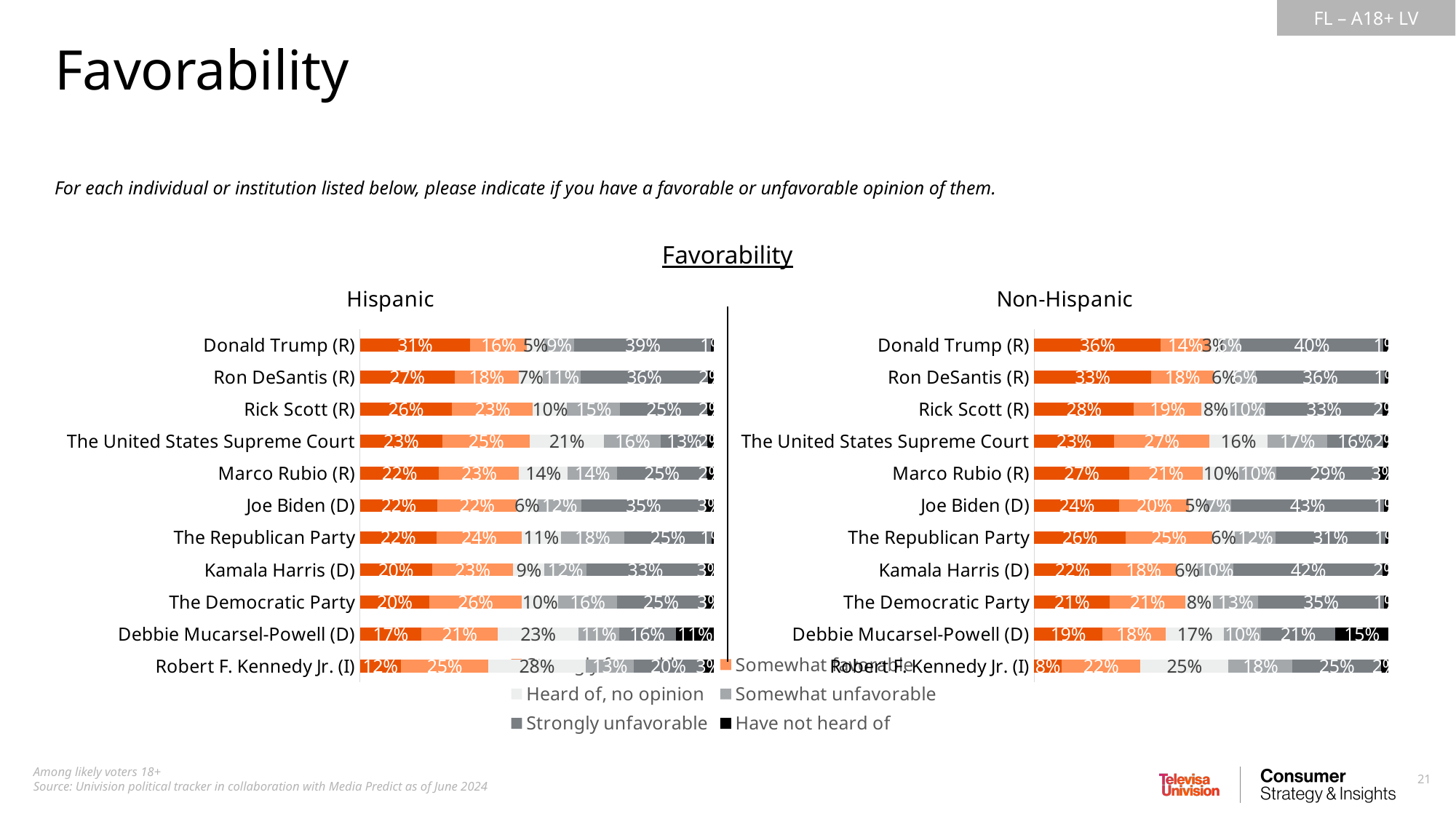
What is the difference between the first dark orange segment for Donald Trump (R) in the Non-Hispanic chart (36%) and in the Hispanic chart (31%)? 5 percentage points What type of chart is used to show the Non-Hispanic favorability data? Stacked bar chart In the Non-Hispanic chart, what is the 'Strongly unfavorable' value for Kamala Harris (D)? 42% In the Hispanic chart, what is the 'Heard of, no opinion' value for Robert F. Kennedy Jr. (I)? 28% In the Hispanic chart, what is the value of the dark gray 'Strongly unfavorable' segment for Joe Biden (D)? 35% In the Non-Hispanic chart, which individual or institution has the highest 'Strongly unfavorable' value? Joe Biden (D) In the Hispanic chart, which has the larger first dark orange segment: Rick Scott (R) or Marco Rubio (R)? Rick Scott (R) How many individuals or institutions are listed in the Hispanic chart? 11 In the Non-Hispanic chart, what is the 'Have not heard of' value for Debbie Mucarsel-Powell (D)? 15% In the Non-Hispanic chart, what is the 'Somewhat favorable' value for The United States Supreme Court? 27% In the Hispanic chart, which individual or institution has the highest value in the first dark orange segment? Donald Trump (R) What is the title shown above the two charts? Favorability